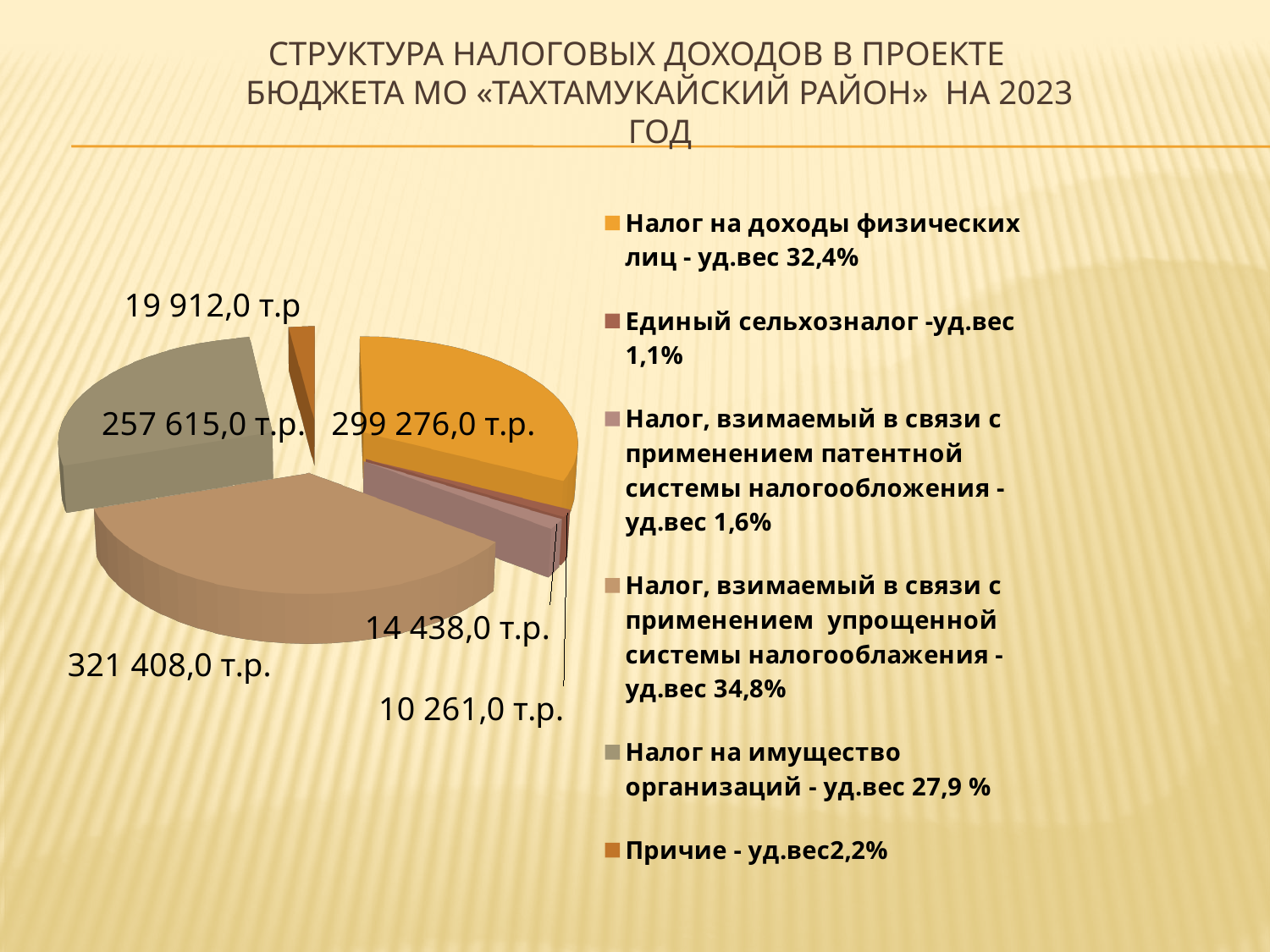
Which category has the largest slice of the pie? Налог, взимаемый в связи с применением упрощенной системы налогообложения How many slices does the pie chart have? 6 How many entries does the legend list? 6 What share of the pie does Налог на имущество организаций have, according to the legend? 27,9 % What is the value shown for Налог, взимаемый в связи с применением упрощенной системы налогообложения? 321 408,0 т.р. What is the value shown for Налог на имущество организаций? 257 615,0 т.р. What is the value shown for Прочие? 19 912,0 т.р Which is larger: the value for Налог на доходы физических лиц or the value for Налог на имущество организаций? Налог на доходы физических лиц Which category has the smallest slice of the pie? Единый сельхозналог What is the value shown for Налог на доходы физических лиц? 299 276,0 т.р. What is the value shown for Единый сельхозналог? 10 261,0 т.р. What kind of chart is shown on the slide? pie chart